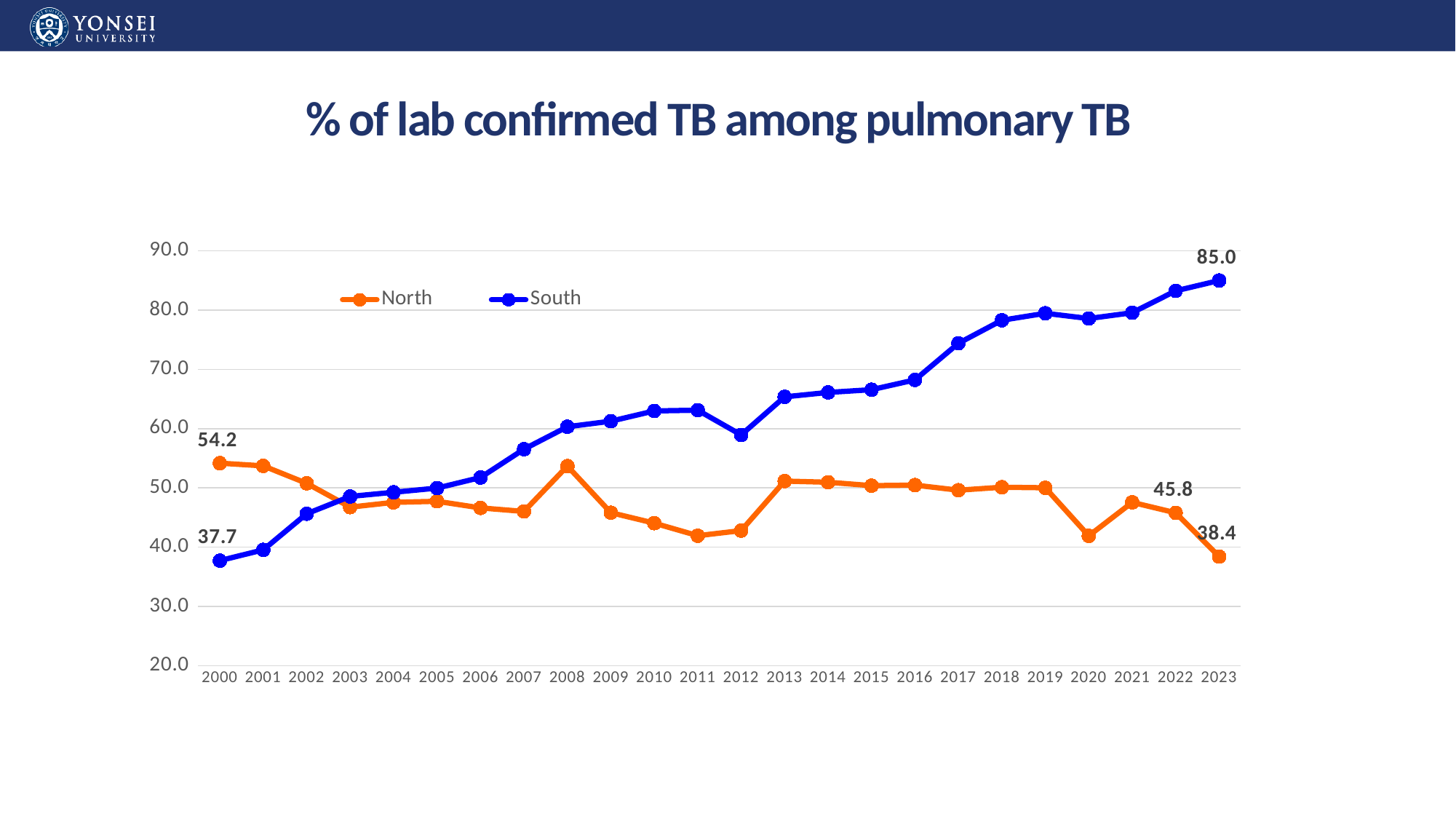
What type of chart is shown on the slide? Line chart What is the value for South in 2000? 37.7 What is the value for North in 2000? 54.2 What is the value for South in 2023? 85.0 What is the value for North in 2023? 38.4 How many years are shown on the x axis? 24 What is the difference between the South value and the North value in 2023? 46.6 Does the South series generally rise or fall from 2000 to 2023? Rise What is the title of the chart? % of lab confirmed TB among pulmonary TB How many series does the legend list? 2 Which series has the higher value in 2000, North or South? North